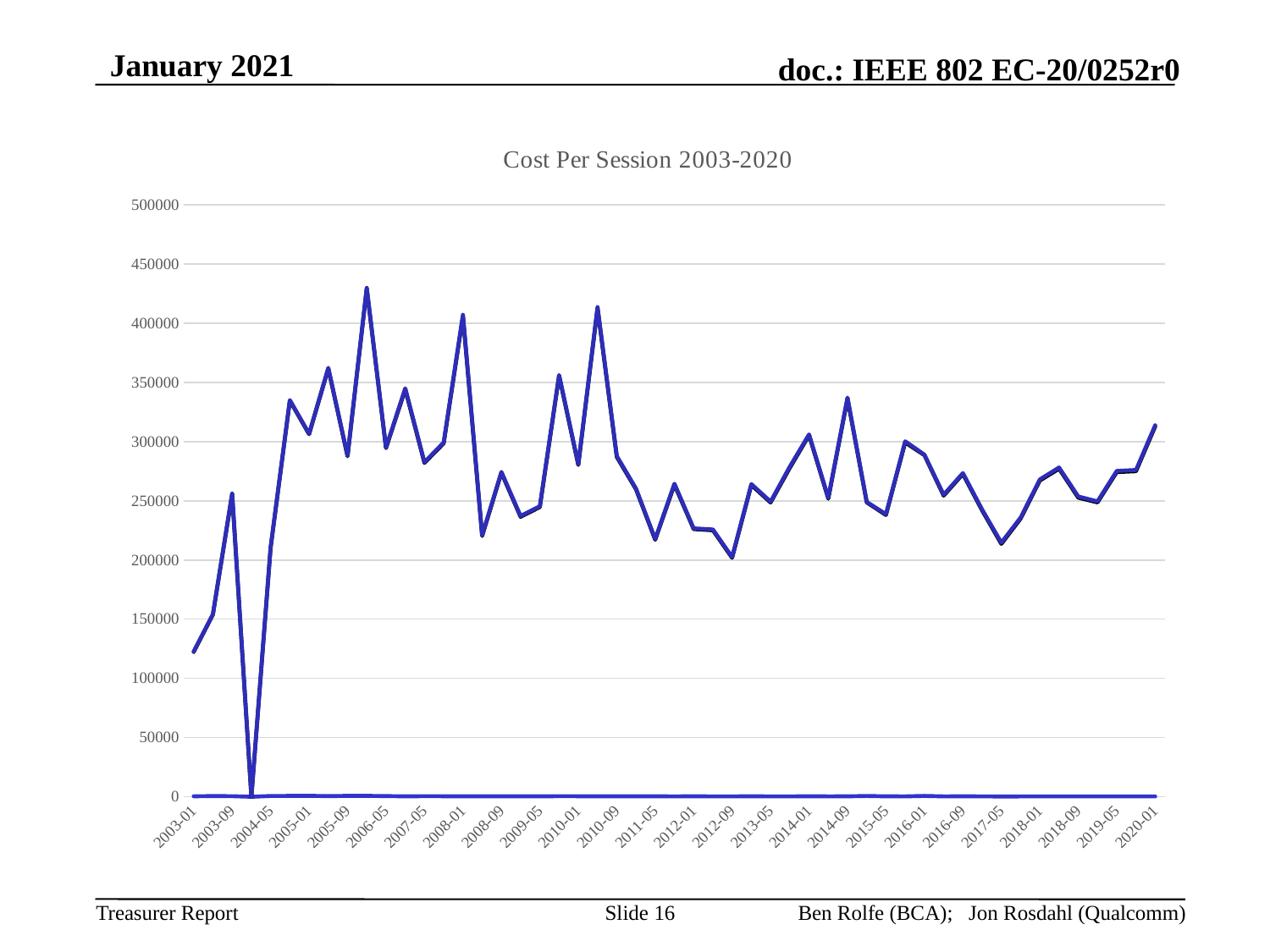
Is the value for 2003-01 greater or less than 150000? less Which has the higher cost per session, 2003-01 or 2020-01? 2020-01 Is the value for 2017-05 greater or less than 250000? less What kind of chart is shown on the slide? line chart Is the value for 2014-09 greater or less than 300000? greater Which has the higher cost per session, 2008-01 or 2012-09? 2008-01 What is the title of the chart? Cost Per Session 2003-2020 Does the cost per session rise or fall from 2014-09 to 2015-05? fall Does the cost per session rise or fall from 2003-01 to 2003-09? rise